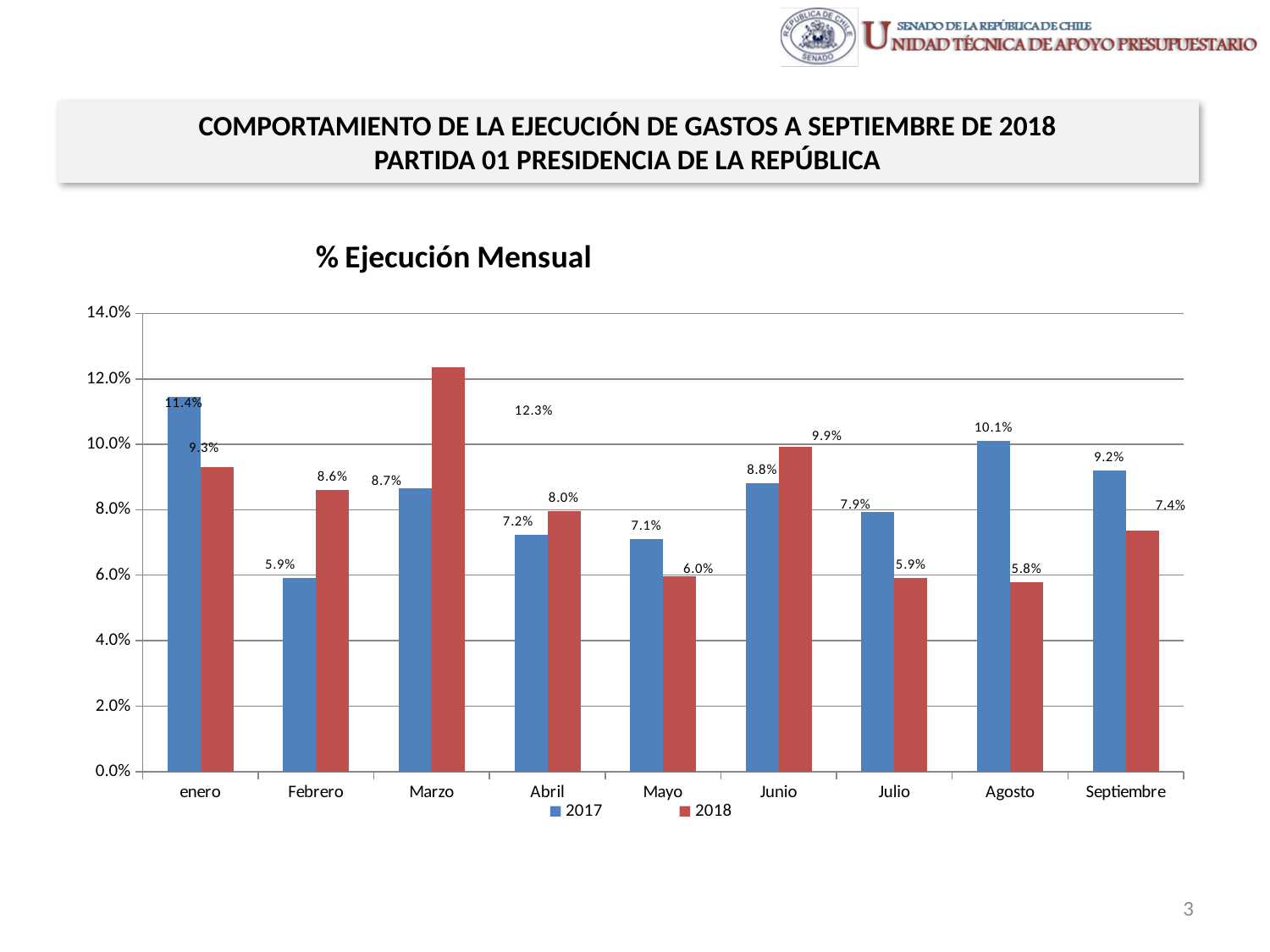
How many months are shown on the x axis? 9 Is the value for 2018 in Junio greater or less than 8.0%? greater What is the title of the chart? % Ejecución Mensual What is the value for 2017 in Agosto? 10.1% Which month has the lowest value for the 2018 series? Agosto How many series does the legend list? 2 What is the value for 2018 in Marzo? 12.3% Which month has the highest value for the 2017 series? enero What type of chart is shown on the slide? bar chart What is the difference between the 2017 and 2018 values in Agosto? 4.3% What is the value for 2018 in Septiembre? 7.4% In Febrero, which series has the larger value, 2017 or 2018? 2018